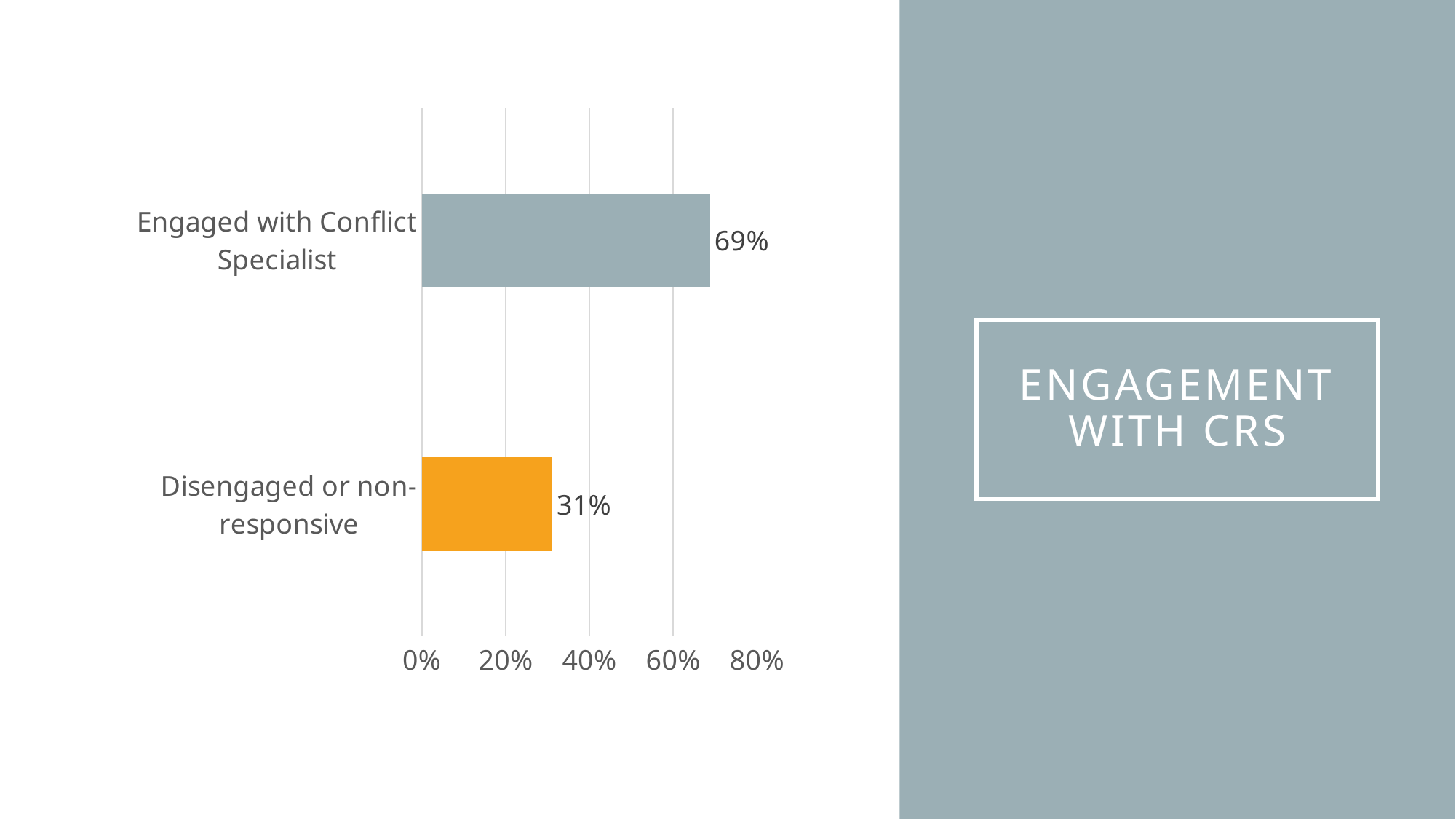
What percentage is shown for Disengaged or non-responsive? 31% What is the difference between the Engaged with Conflict Specialist value and the Disengaged or non-responsive value? 38% What colour is the bar for Disengaged or non-responsive? Orange Which category has the lowest value? Disengaged or non-responsive What kind of chart is shown on the slide? Bar chart What is the total of the two values shown in the chart? 100% What percentage is shown for Engaged with Conflict Specialist? 69% Which category has the highest value? Engaged with Conflict Specialist How many categories are shown in the chart? 2 Is the value for Engaged with Conflict Specialist greater or less than 60%? greater Which is larger: the value for Engaged with Conflict Specialist or the value for Disengaged or non-responsive? Engaged with Conflict Specialist Is the value for Disengaged or non-responsive greater or less than 40%? less